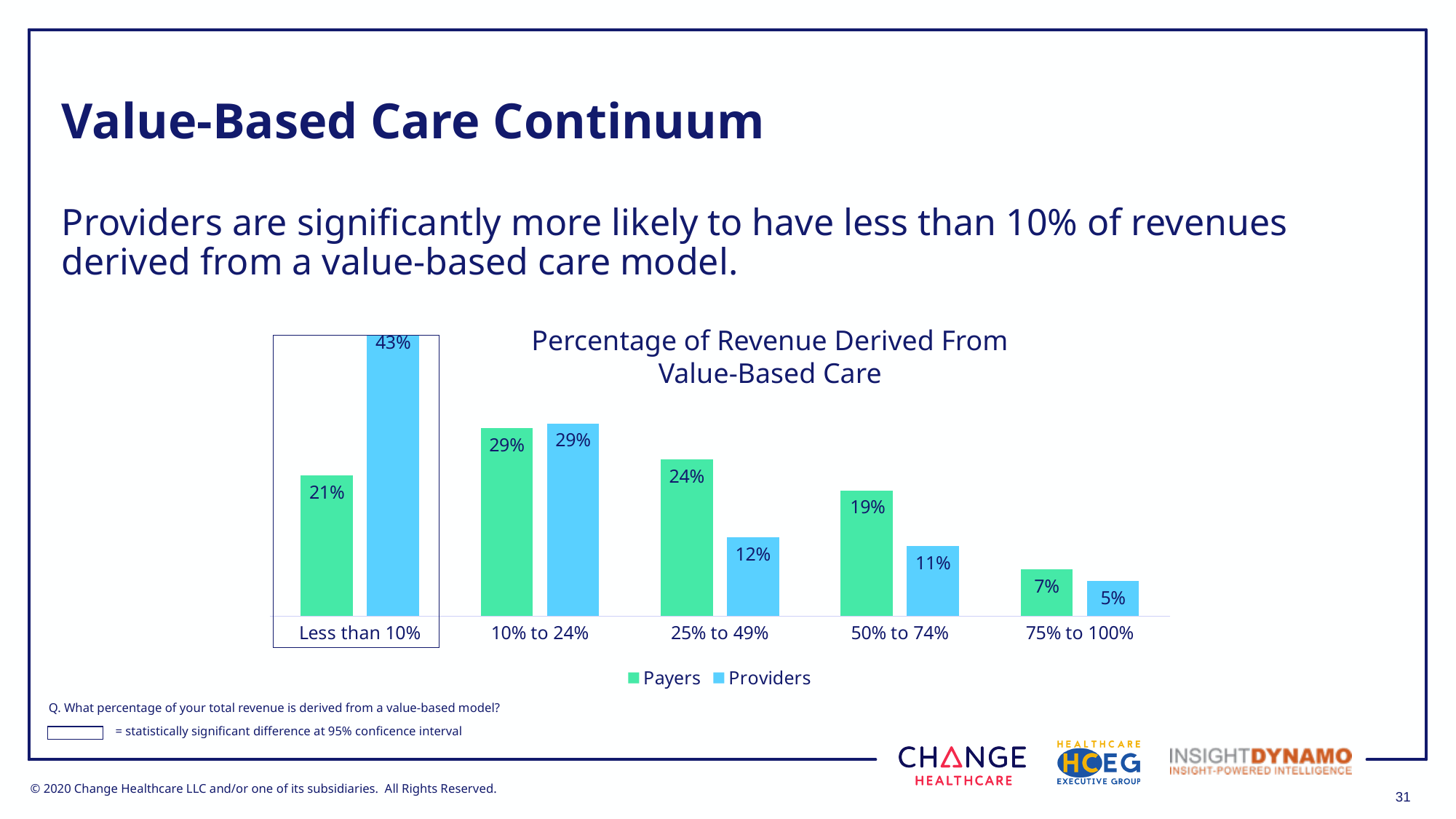
What is the value for Providers in the 'Less than 10%' category? 43% What is the difference between the Providers and Payers values in the 'Less than 10%' category? 22% What is the value for Payers in the '25% to 49%' category? 24% How many series does the legend list? 2 What kind of chart is shown on the slide? Bar chart Do the Providers values rise or fall from '10% to 24%' to '75% to 100%' along the x axis? Fall How many categories are shown on the x axis? 5 Which category has the lowest value for Payers? 75% to 100% What is the title of the chart? Percentage of Revenue Derived From Value-Based Care What is the value for Providers in the '50% to 74%' category? 11% In the '50% to 74%' category, which series has the larger value, Payers or Providers? Payers Which category has the highest value for Providers? Less than 10%